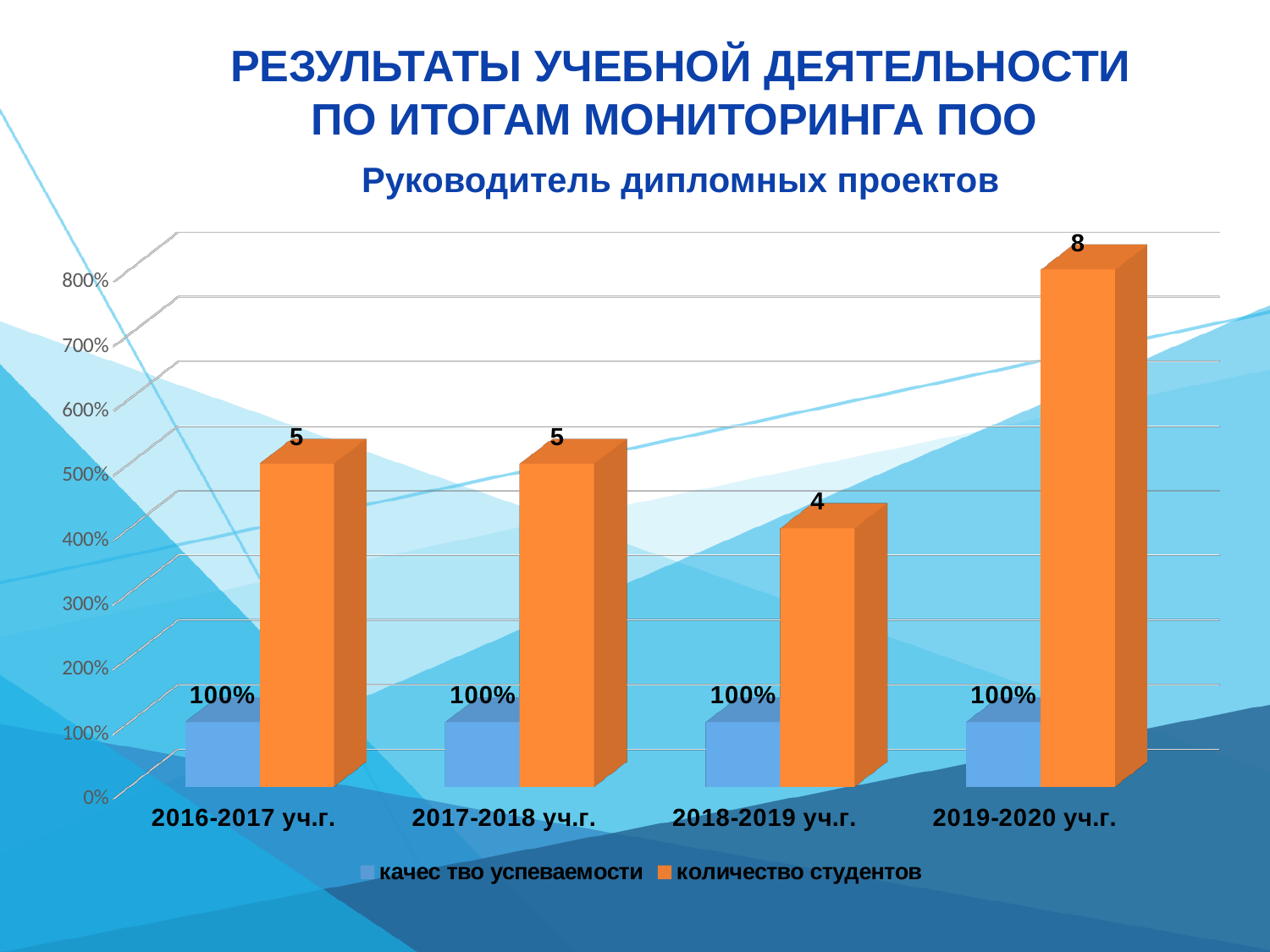
How many academic years are shown on the x axis? 4 Which academic year has the highest количество студентов? 2019-2020 уч.г. What is the difference in количество студентов between 2019-2020 уч.г. and 2018-2019 уч.г.? 4 What colour are the bars for количество студентов? Orange Which is larger, количество студентов for 2016-2017 уч.г. or for 2019-2020 уч.г.? 2019-2020 уч.г. What is the value of качество успеваемости for 2017-2018 уч.г.? 100% What is the value of количество студентов for 2019-2020 уч.г.? 8 What kind of chart is shown on the slide? Bar chart How many series does the legend list? 2 Which academic year has the lowest количество студентов? 2018-2019 уч.г. Does количество студентов rise or fall from 2018-2019 уч.г. to 2019-2020 уч.г.? Rise What is the value of количество студентов for 2018-2019 уч.г.? 4